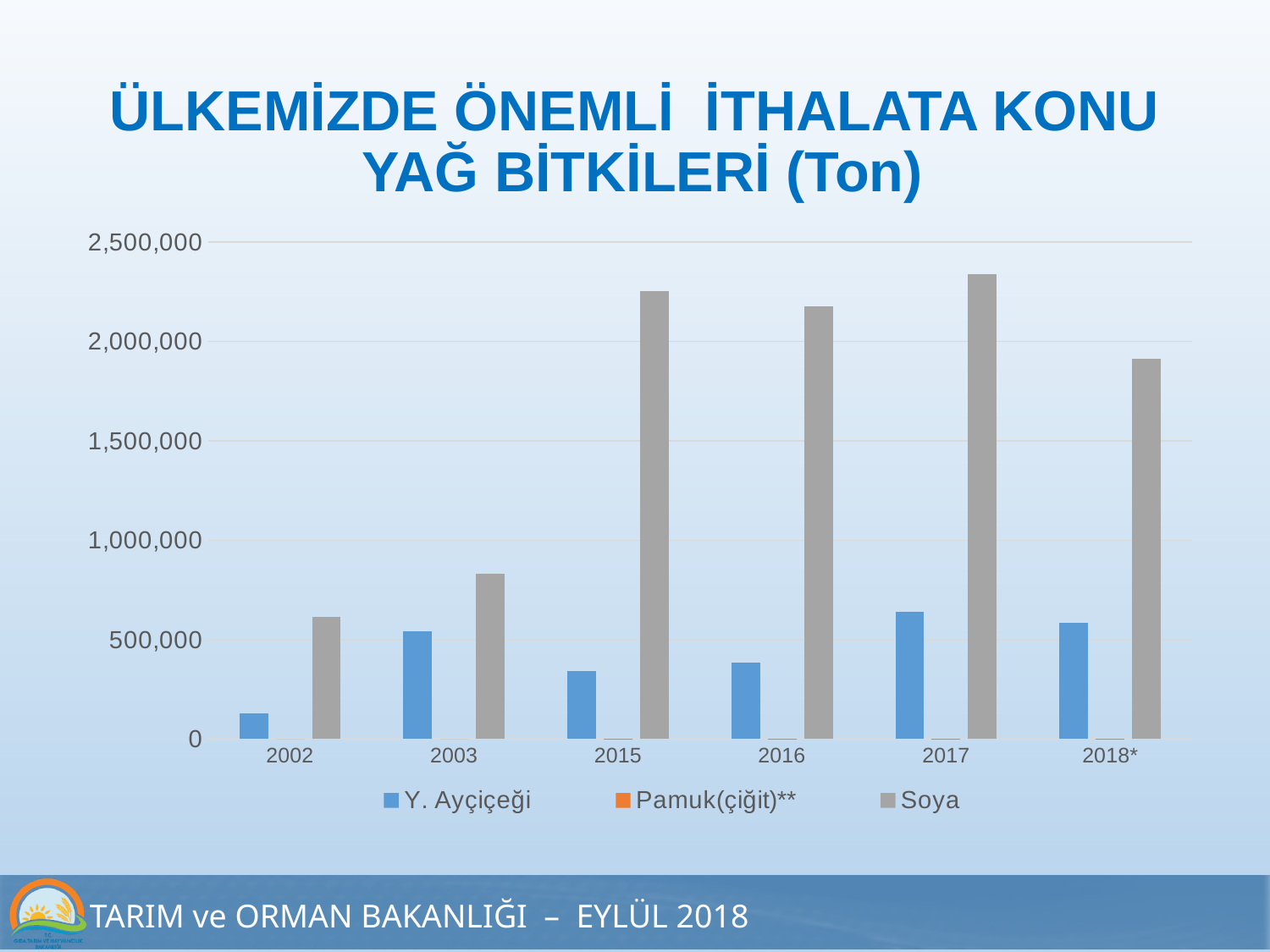
How many year categories are shown on the x axis? 6 How many series does the legend list? 3 Is the Soya value for 2015 greater or less than 2,000,000? greater In which year is the Soya value highest? 2017 Is the Soya value for 2003 greater or less than 1,000,000? less In 2016, which is larger: the Y. Ayçiçeği value or the Soya value? Soya Which series is shown in grey in the legend? Soya Is the Y. Ayçiçeği value for 2015 greater or less than 500,000? less In which year is the Y. Ayçiçeği value lowest? 2002 In which year is the Soya value lowest? 2002 What kind of chart is shown on the slide? bar chart